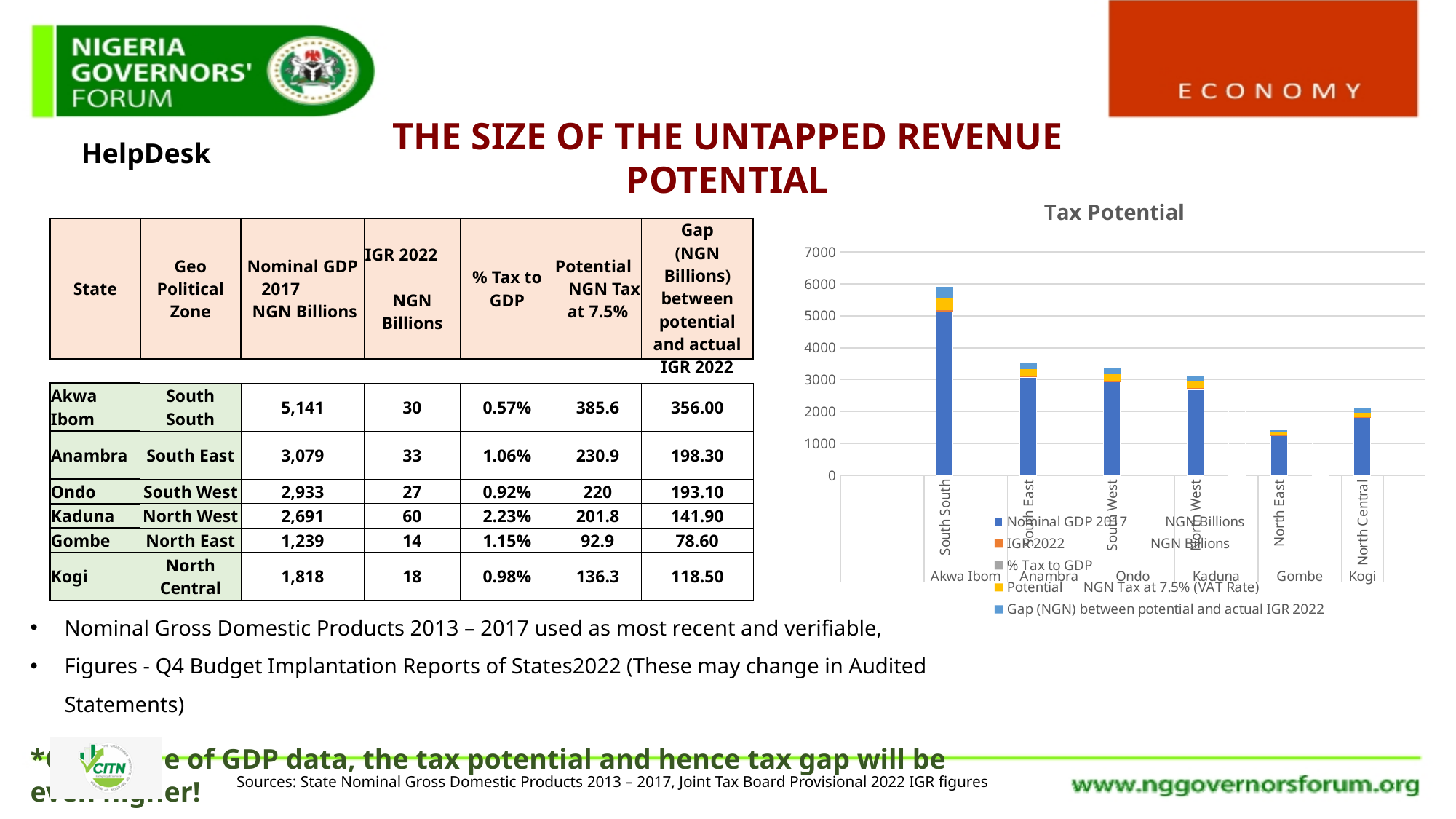
How many series does the legend of the Tax Potential chart list? 5 On the Tax Potential chart, is the total stacked bar for Anambra greater or less than 3000? greater What kind of chart is the Tax Potential chart? stacked bar chart What is the title of the chart on the slide? Tax Potential How many states (categories) are plotted on the Tax Potential chart? 6 Which state has the shortest stacked bar on the Tax Potential chart? Gombe On the Tax Potential chart, what colour represents the Nominal GDP 2017 NGN Billions series? blue Which state has the tallest stacked bar on the Tax Potential chart? Akwa Ibom On the Tax Potential chart, which stacked bar is taller: Gombe or Kogi? Kogi On the Tax Potential chart, is the total stacked bar for Akwa Ibom greater or less than 5000? greater On the Tax Potential chart, is the total stacked bar for Gombe greater or less than 2000? less